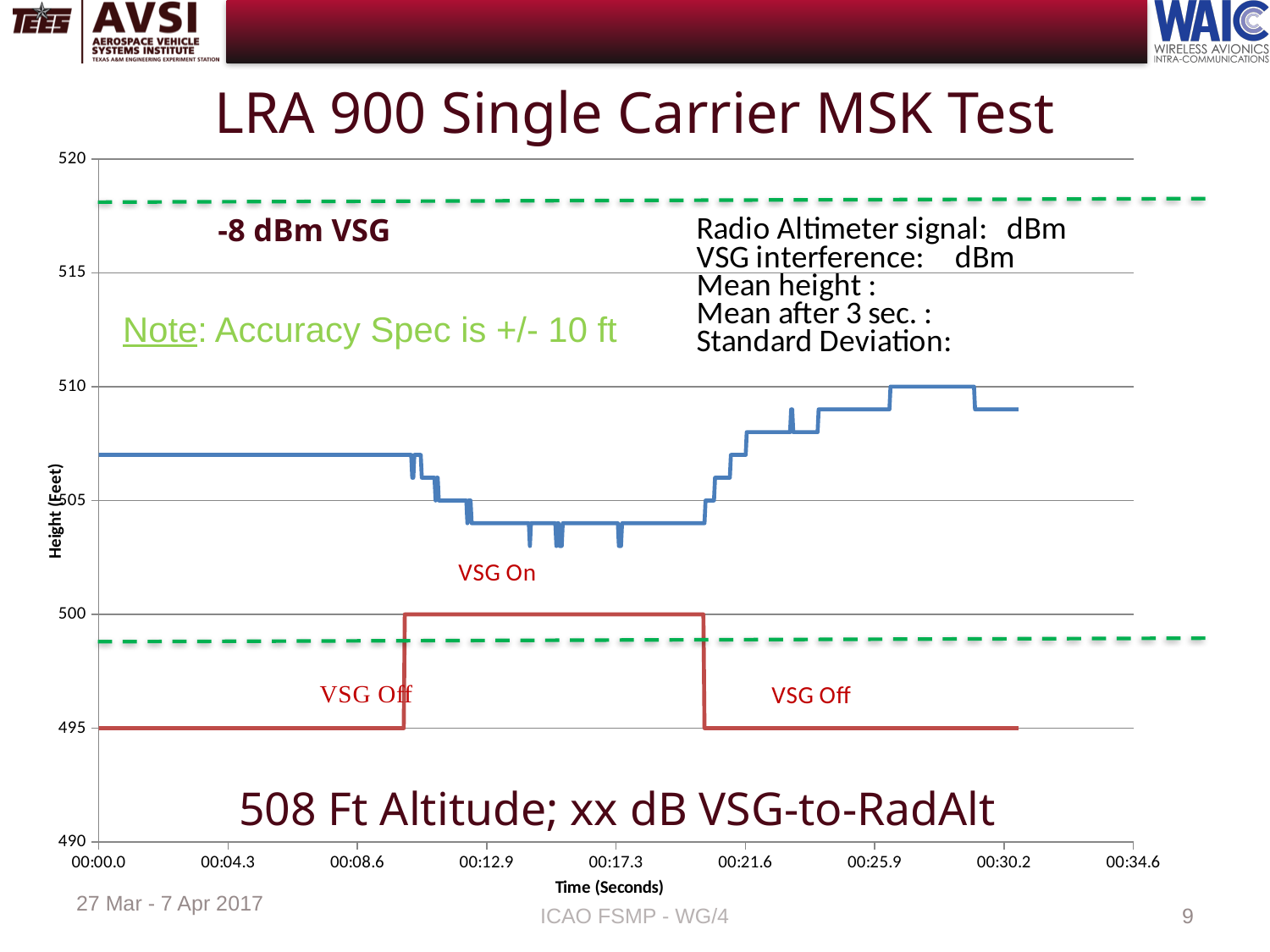
What value does the red VSG line sit at while the VSG is off? 495 Does the blue height line rise or fall between 00:08.6 and 00:17.3? fall What is the highest height value reached by the blue line? 510 What kind of chart is shown on the slide? line chart What is the label of the vertical axis? Height (Feet) What is the difference between the red line's VSG On level and its VSG Off level? 5 How many tick labels are shown on the time axis? 9 According to the note on the chart, what is the accuracy spec? +/- 10 ft What value does the red VSG line rise to while the VSG is on? 500 Is the blue height line at time 00:17.3 greater or less than 505? less Is the blue height line at time 00:00.0 greater or less than 505? greater Is the blue height line higher at 00:25.9 or at 00:00.0? 00:25.9